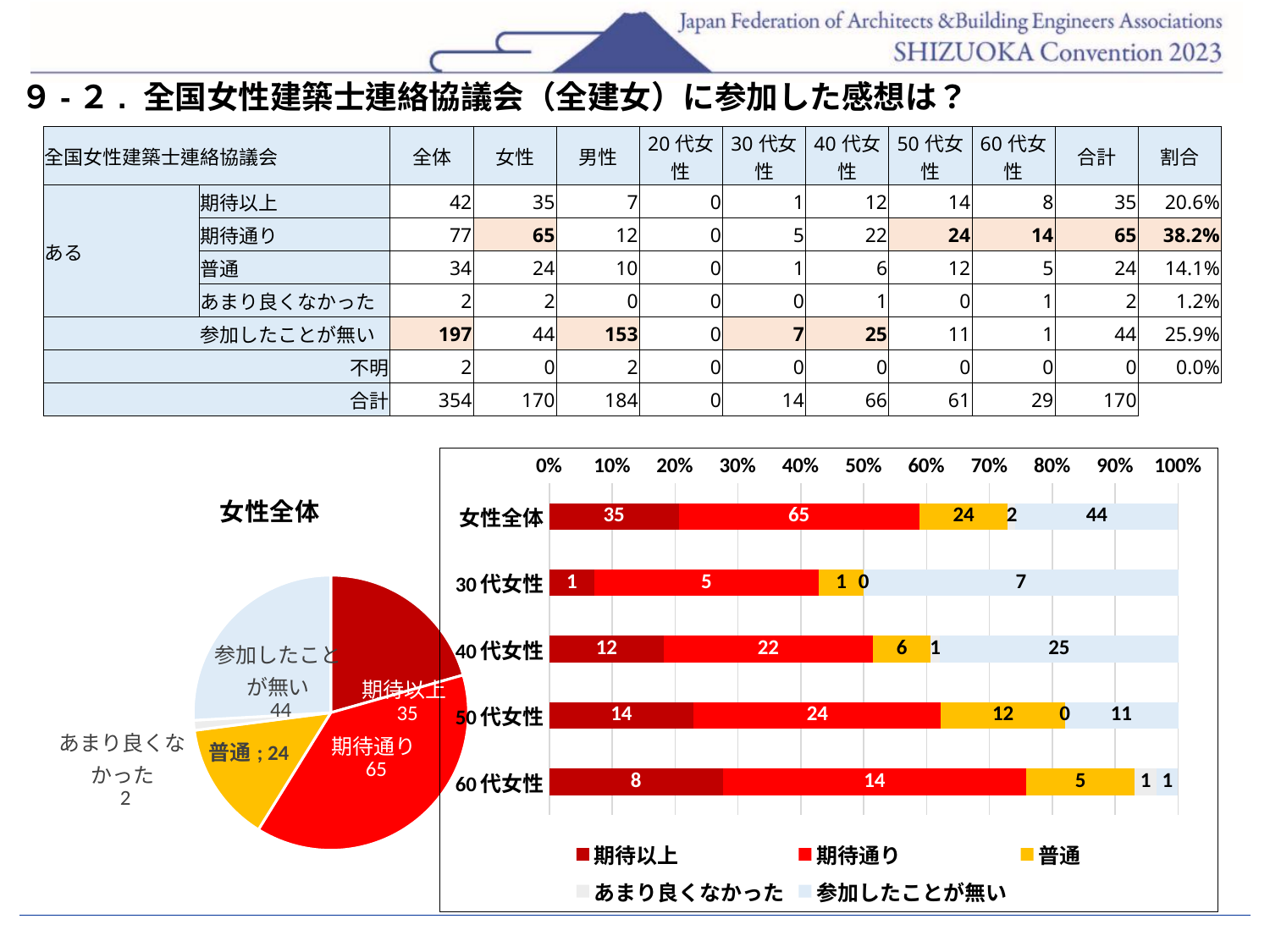
In the bar chart on the right, how many series does the legend list? 5 What kind of chart is the chart on the right of the slide? bar chart In the bar chart on the right, what is the total of the stacked bar for 60代女性? 29 In the bar chart on the right, what is the value of 期待通り for 40代女性? 22 In the bar chart on the right, what is the value of 参加したことが無い for 50代女性? 11 In the pie chart titled 女性全体, what is the value of the 参加したことが無い slice? 44 In the bar chart on the right, which series has the largest value in the 女性全体 bar? 期待通り In the bar chart on the right, what is the total of the stacked bar for 女性全体? 170 In the bar chart on the right, how many categories are shown on the vertical axis? 5 In the pie chart titled 女性全体, what share of the total does the 期待通り slice represent? 38.2% What kind of chart is the chart titled 女性全体 on the left of the slide? pie chart In the bar chart on the right, what is the difference between 期待通り and 期待以上 for 女性全体? 30